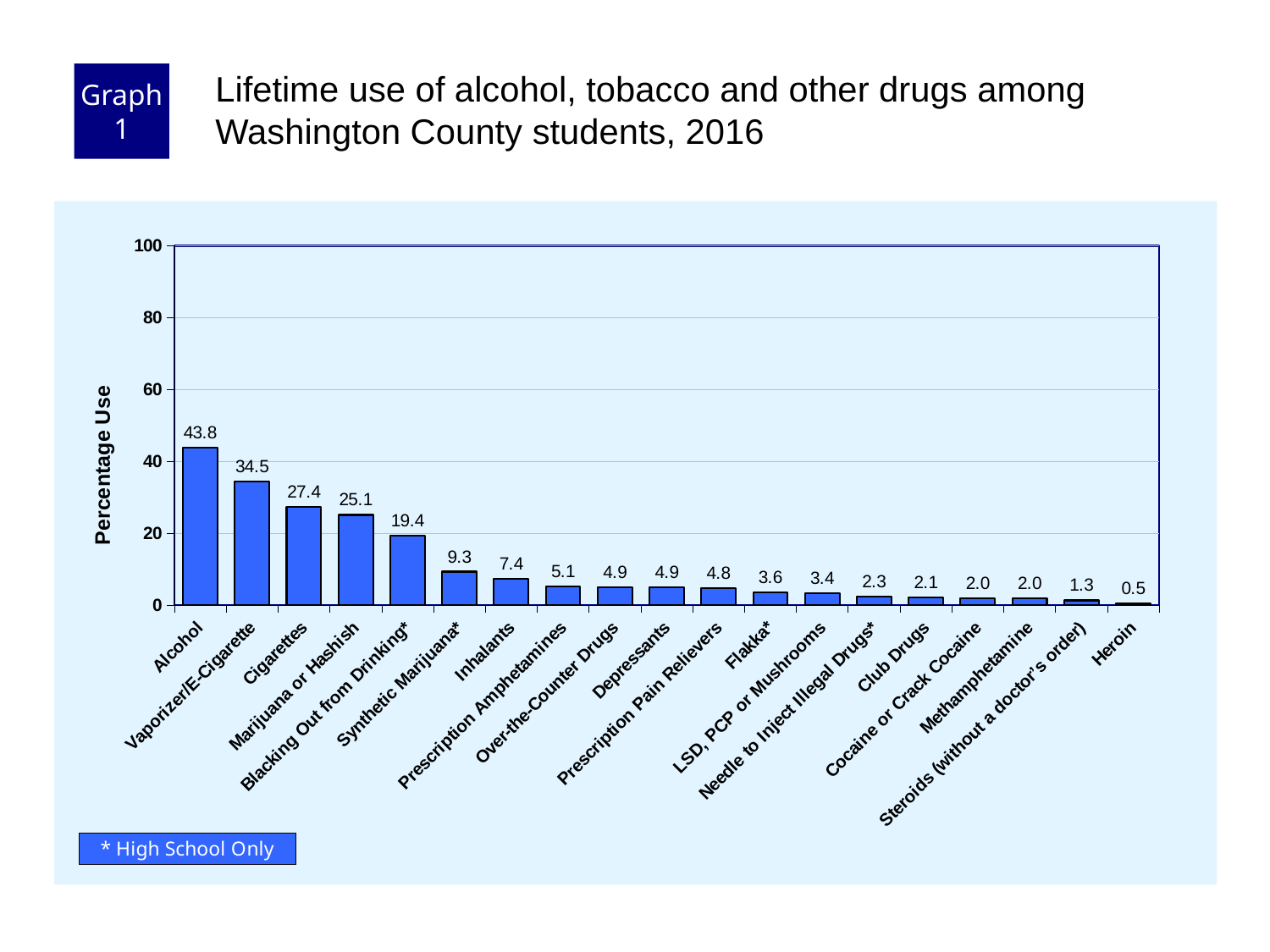
What is the value for Heroin? 0.5 What is the value for Vaporizer/E-Cigarette? 34.5 What kind of chart is this? Bar chart What is the value for Alcohol? 43.8 Which is larger, the value for Marijuana or Hashish or the value for Blacking Out from Drinking*? Marijuana or Hashish Which category has the lowest value? Heroin Do the values rise or fall from left to right along the x axis? Fall Which category has the highest value? Alcohol How many categories are shown on the chart? 19 What is the label of the y axis? Percentage Use What is the difference between the values for Alcohol and Cigarettes? 16.4 What is the value for Synthetic Marijuana*? 9.3